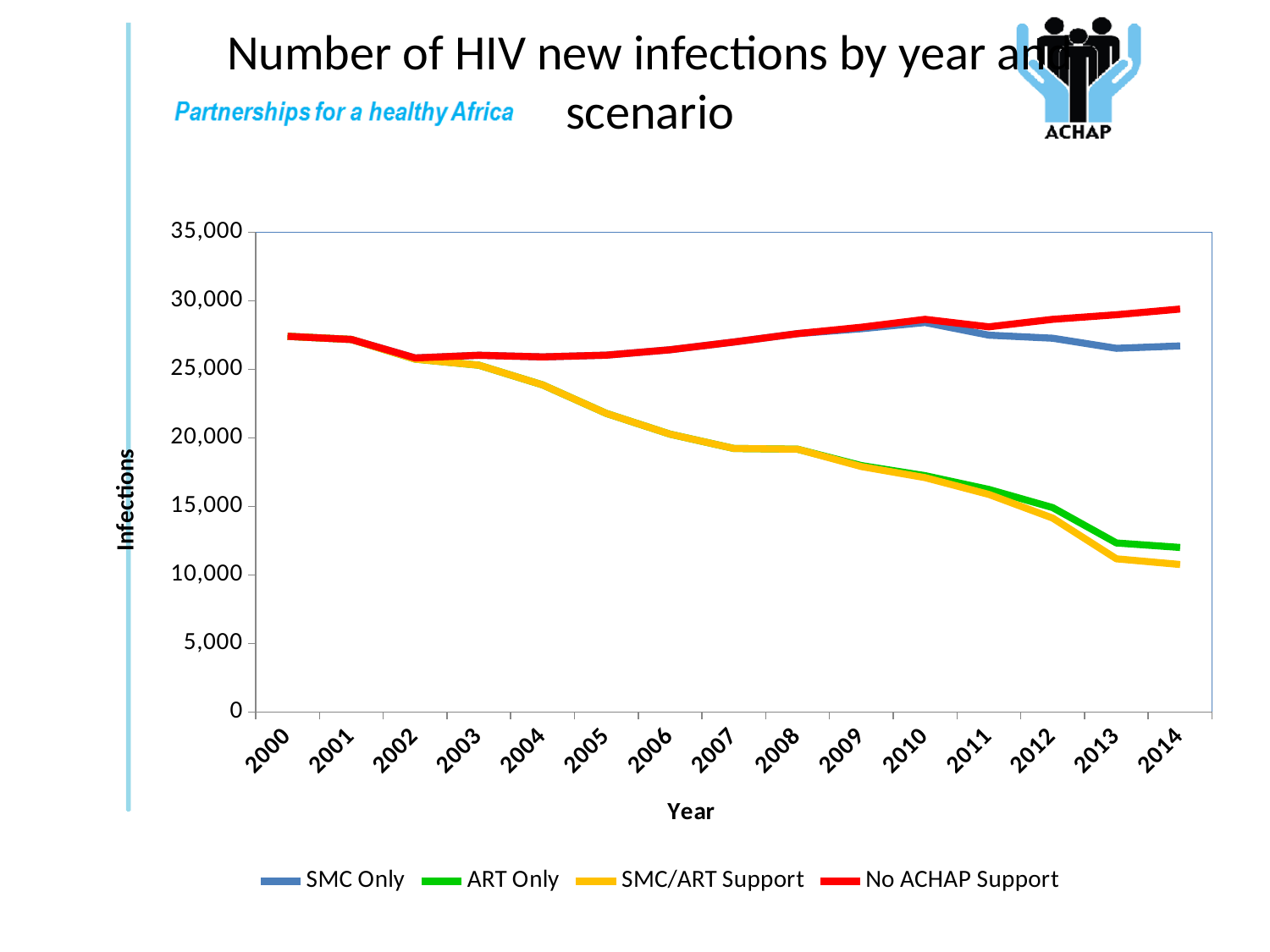
Which series has the lowest value in 2014? SMC/ART Support Is the value for ART Only in 2010 greater or less than 20,000? less Does the No ACHAP Support series rise or fall from 2005 to 2014? rise How many years are plotted along the x axis? 15 Is the value for No ACHAP Support in 2014 greater or less than 25,000? greater What kind of chart is shown on the slide? line chart Which series has the highest value in 2014? No ACHAP Support In 2014, which is larger: ART Only or SMC/ART Support? ART Only Does the SMC/ART Support series rise or fall from 2000 to 2014? fall Is the value for SMC/ART Support in 2014 greater or less than 15,000? less How many series does the legend list? 4 What is the label on the y axis? Infections